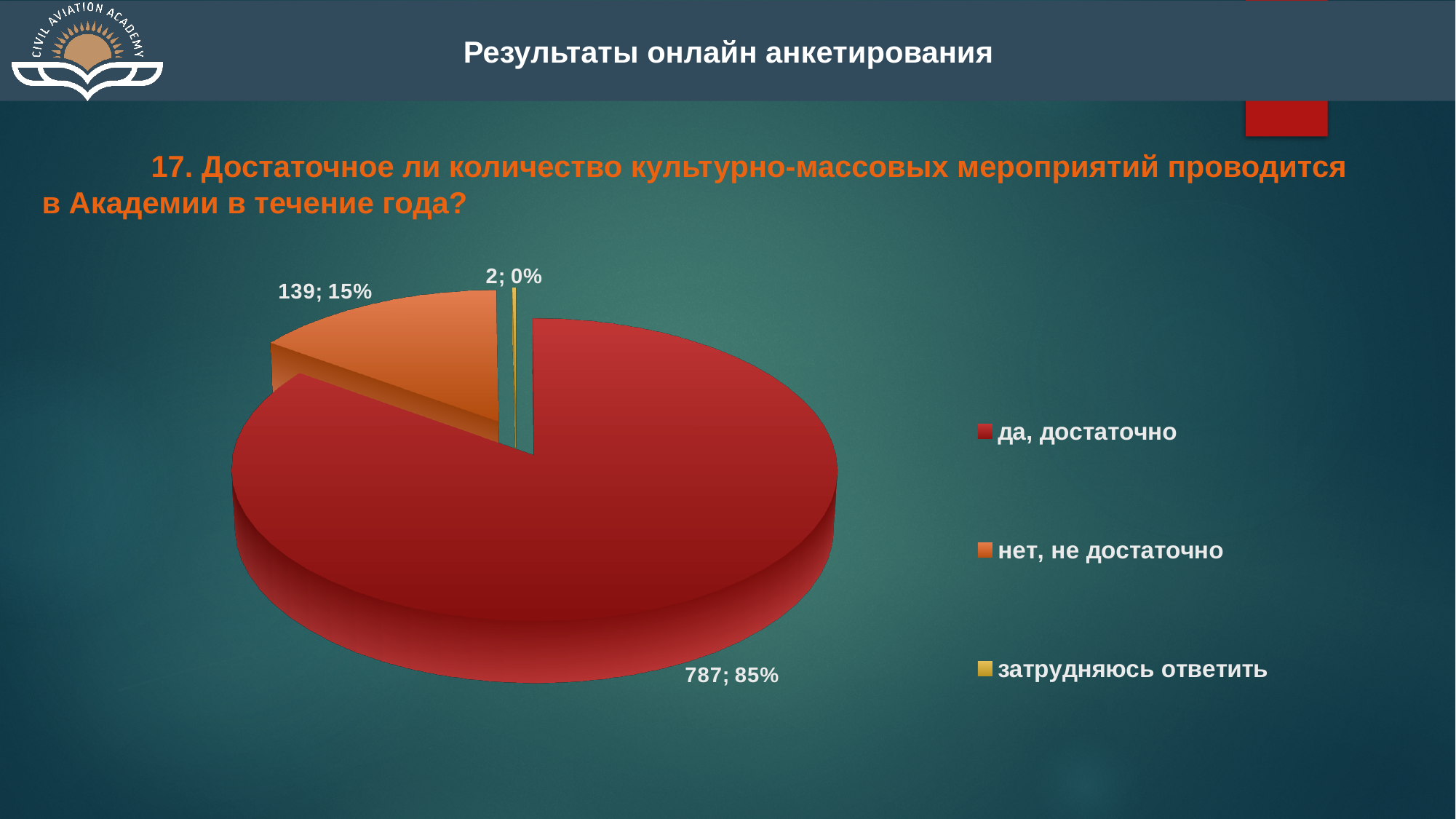
How many respondents answered "затрудняюсь ответить"? 2 What share of the pie does "нет, не достаточно" take? 15% How many answer options does the legend list? 3 What colour is the slice for "нет, не достаточно"? orange How many respondents answered "да, достаточно"? 787 What share of the pie does "да, достаточно" take? 85% Which has more responses: "нет, не достаточно" or "затрудняюсь ответить"? нет, не достаточно Which answer option has the largest slice? да, достаточно How many respondents answered "нет, не достаточно"? 139 What is the difference between the number of "да, достаточно" and "нет, не достаточно" responses? 648 Which answer option has the smallest slice? затрудняюсь ответить What kind of chart is shown on the slide? pie chart